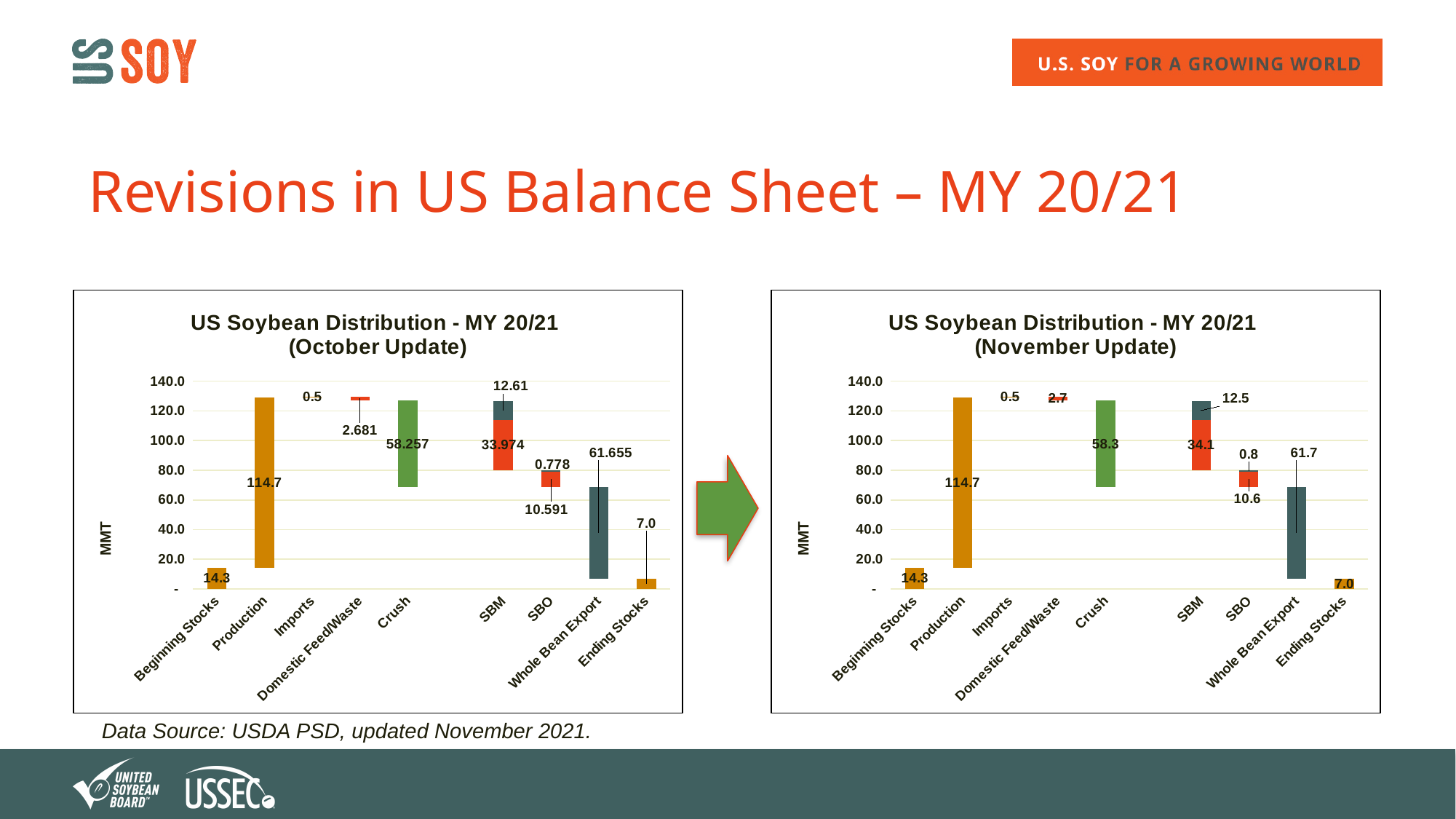
How many categories are shown on the x axis of the November Update chart? 9 In the November Update chart, which category has the lowest value? Imports What is the y-axis label on the October Update chart? MMT In the October Update chart, what is the value for Crush? 58.257 In the November Update chart, what is the value for Whole Bean Export? 61.7 In the October Update chart, which category has the highest value? Production In the October Update chart, what is the value for Production? 114.7 In the November Update chart, which is larger, Whole Bean Export or Crush? Whole Bean Export In the November Update chart, what is the value for Crush? 58.3 In the October Update chart, what is the value for Whole Bean Export? 61.655 In the November Update chart, what is the value for Domestic Feed/Waste? 2.7 In the October Update chart, what is the difference between Production and Crush? 56.443